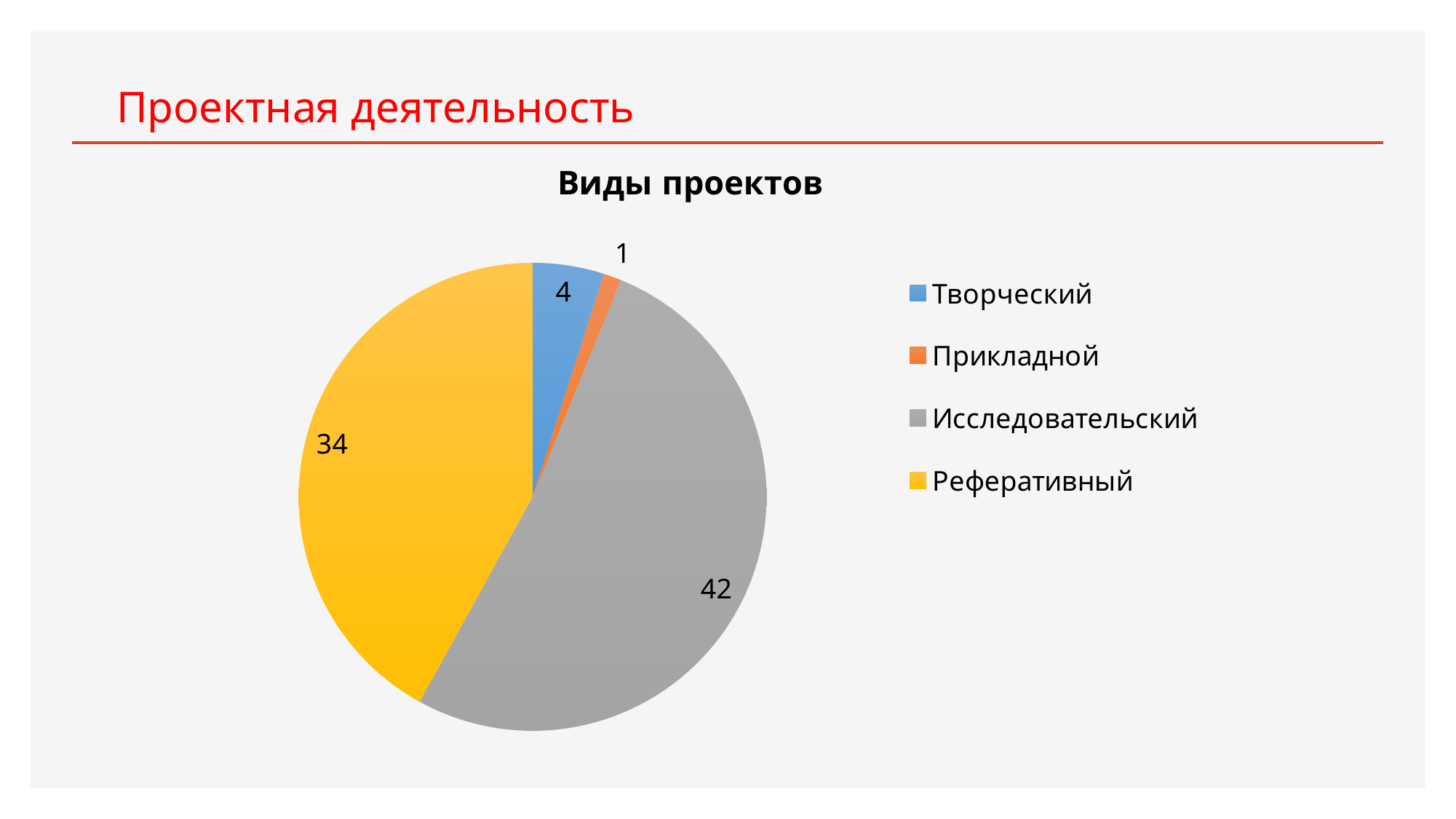
Which category has the smallest slice? Прикладной How many categories does the legend list? 4 What is the difference between the values for Исследовательский and Реферативный? 8 What is the value for Реферативный? 34 What is the value for Исследовательский? 42 Which category has the largest slice? Исследовательский What is the value for Творческий? 4 What is the title of the chart? Виды проектов What kind of chart is shown on the slide? pie chart Which is larger, the value for Творческий or the value for Прикладной? Творческий What is the total of all the slices in the pie? 81 What is the value for Прикладной? 1